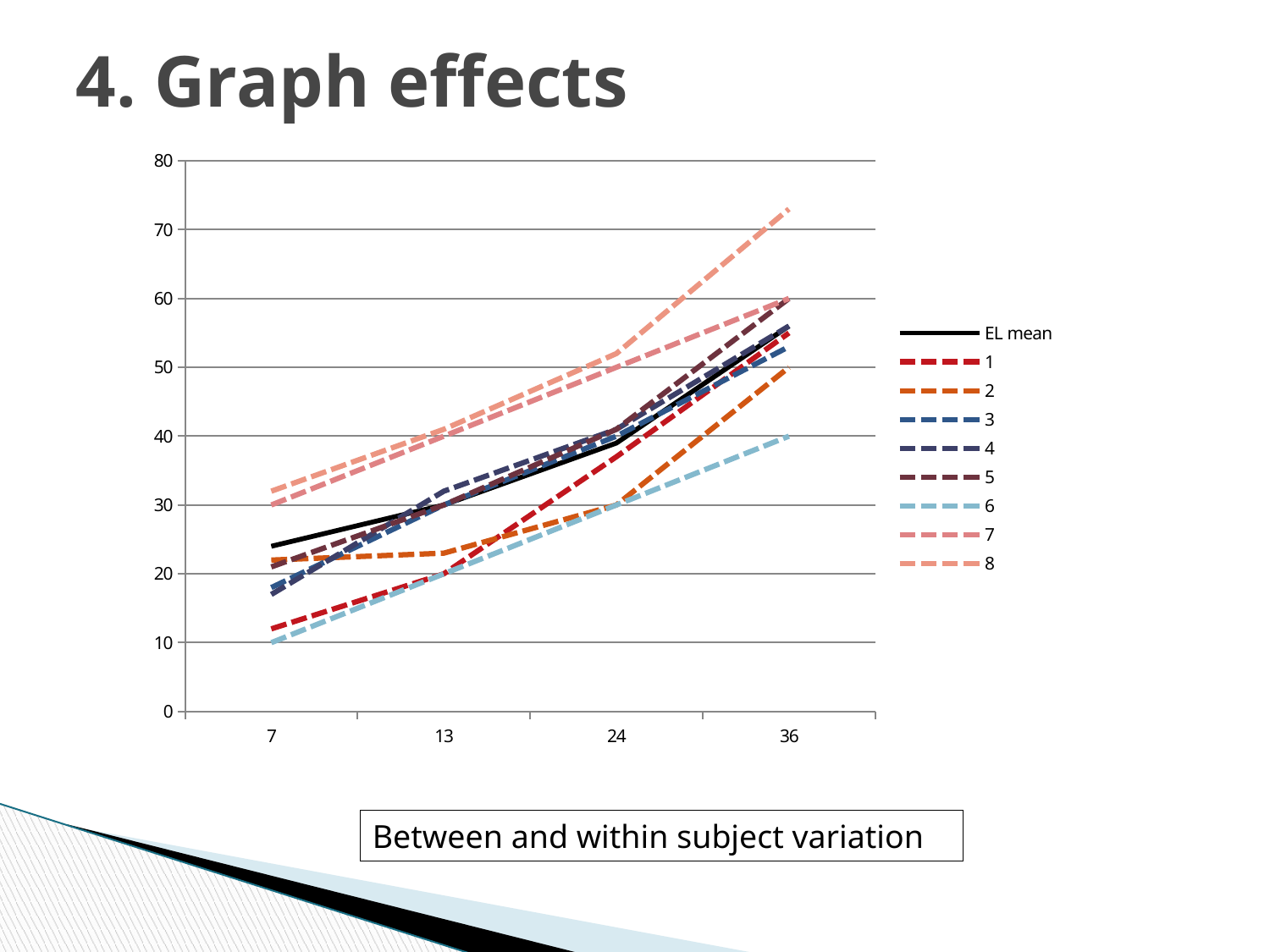
Which series has the lowest value at x = 7? 6 Which series has the lowest value at x = 36? 6 How many points are there along the x axis? 4 Is the value for EL mean at x = 7 greater or less than 30? less Which series has the highest value at x = 36? 8 What kind of chart is shown on the slide? line chart Does the EL mean line rise or fall from 7 to 36 along the x axis? rise Is the value for series 6 at x = 36 greater or less than 50? less Is the value for series 8 at x = 36 greater or less than 70? greater Which legend entry is drawn as a solid black line? EL mean At x = 36, which is larger: series 8 or series 6? 8 How many series does the legend list? 9